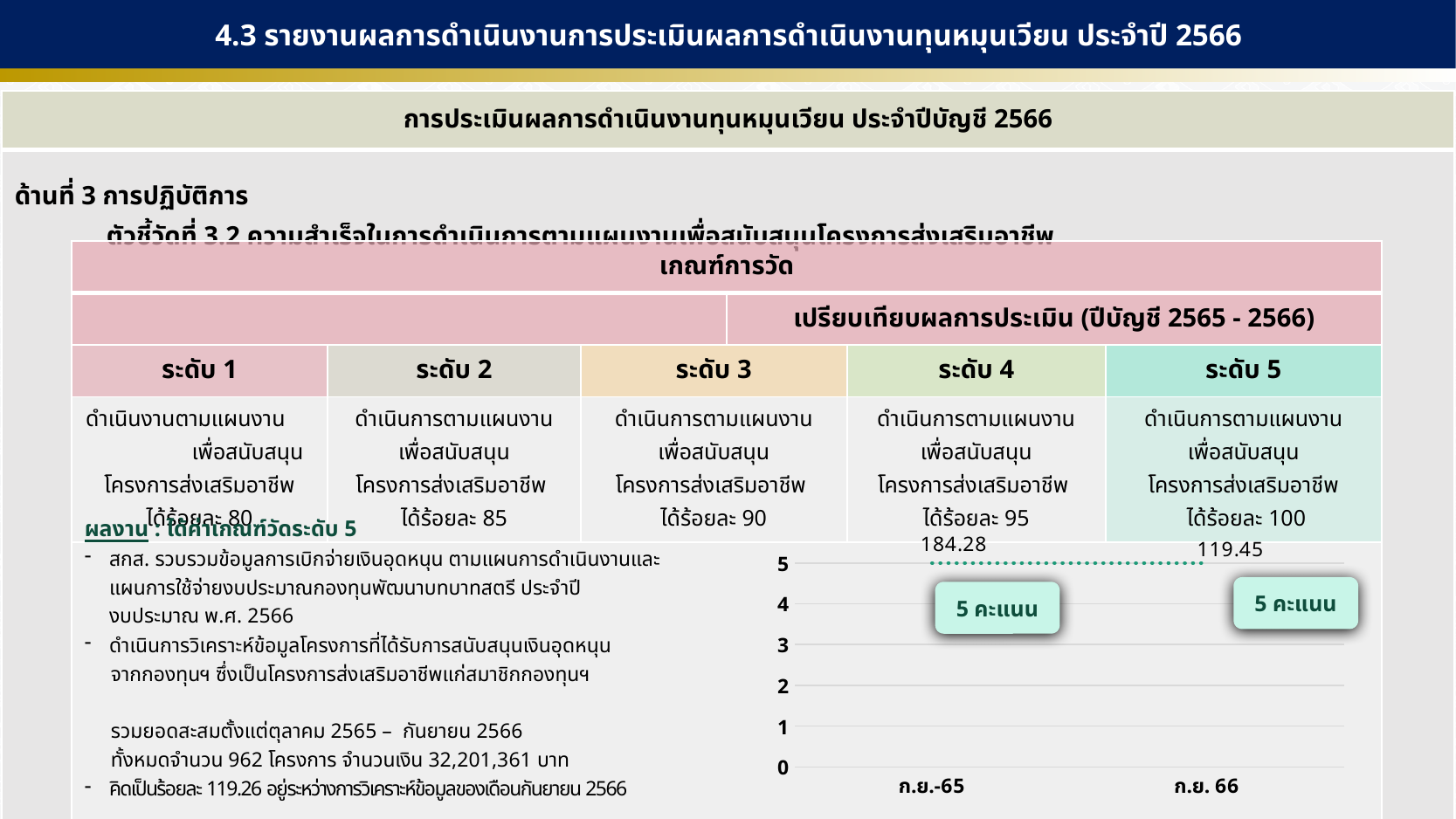
What score is shown in the box for ก.ย. 66 in the chart? 5 คะแนน What is the highest value shown on the y axis of the chart? 5 At which y-axis level does the dotted line in the chart sit for both categories? 5 What are the two category labels on the x axis of the chart? ก.ย.-65 and ก.ย. 66 What is the difference between the labelled values for ก.ย.-65 and ก.ย. 66 in the chart? 64.83 How many categories are shown on the x axis of the chart? 2 Which category has the higher labelled value in the chart, ก.ย.-65 or ก.ย. 66? ก.ย.-65 What score is shown in the box for ก.ย.-65 in the chart? 5 คะแนน What value is labelled above the point for ก.ย.-65 in the chart? 184.28 Is the labelled value for ก.ย. 66 greater or less than 184.28? less What value is labelled above the point for ก.ย. 66 in the chart? 119.45